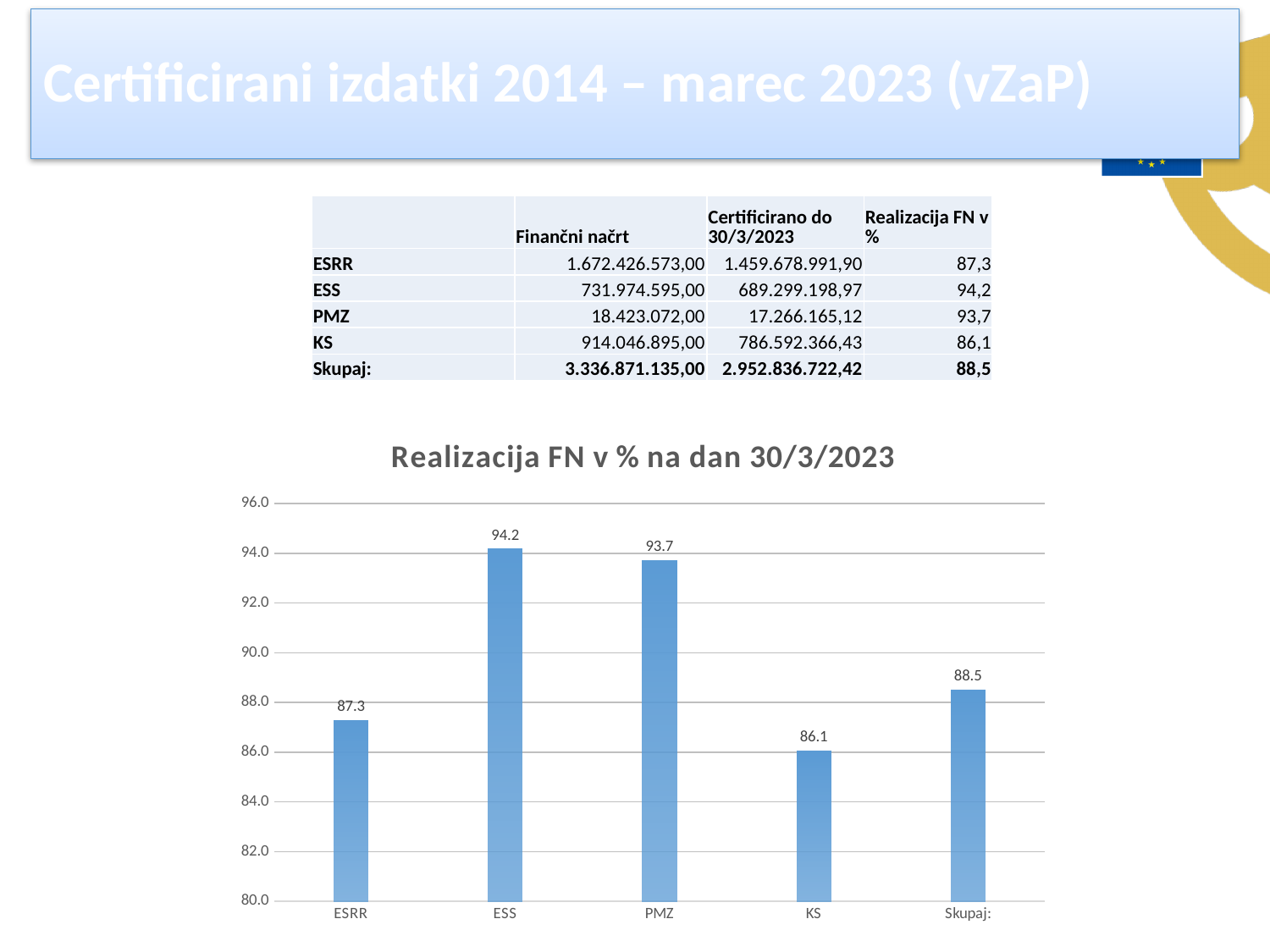
Which category has the highest value in the chart? ESS What is the value for KS in the chart? 86.1 Is the value for PMZ greater or less than 92.0? greater Which category has the lowest value in the chart? KS Which is larger, the value for ESRR or the value for Skupaj:? Skupaj: What kind of chart is shown on the slide? bar chart What is the title of the chart? Realizacija FN v % na dan 30/3/2023 How many categories are shown on the x axis of the chart? 5 What is the difference between the values for ESS and KS? 8.1 What is the value for ESS in the chart? 94.2 What is the value for Skupaj: in the chart? 88.5 What is the difference between the values for PMZ and ESRR? 6.4